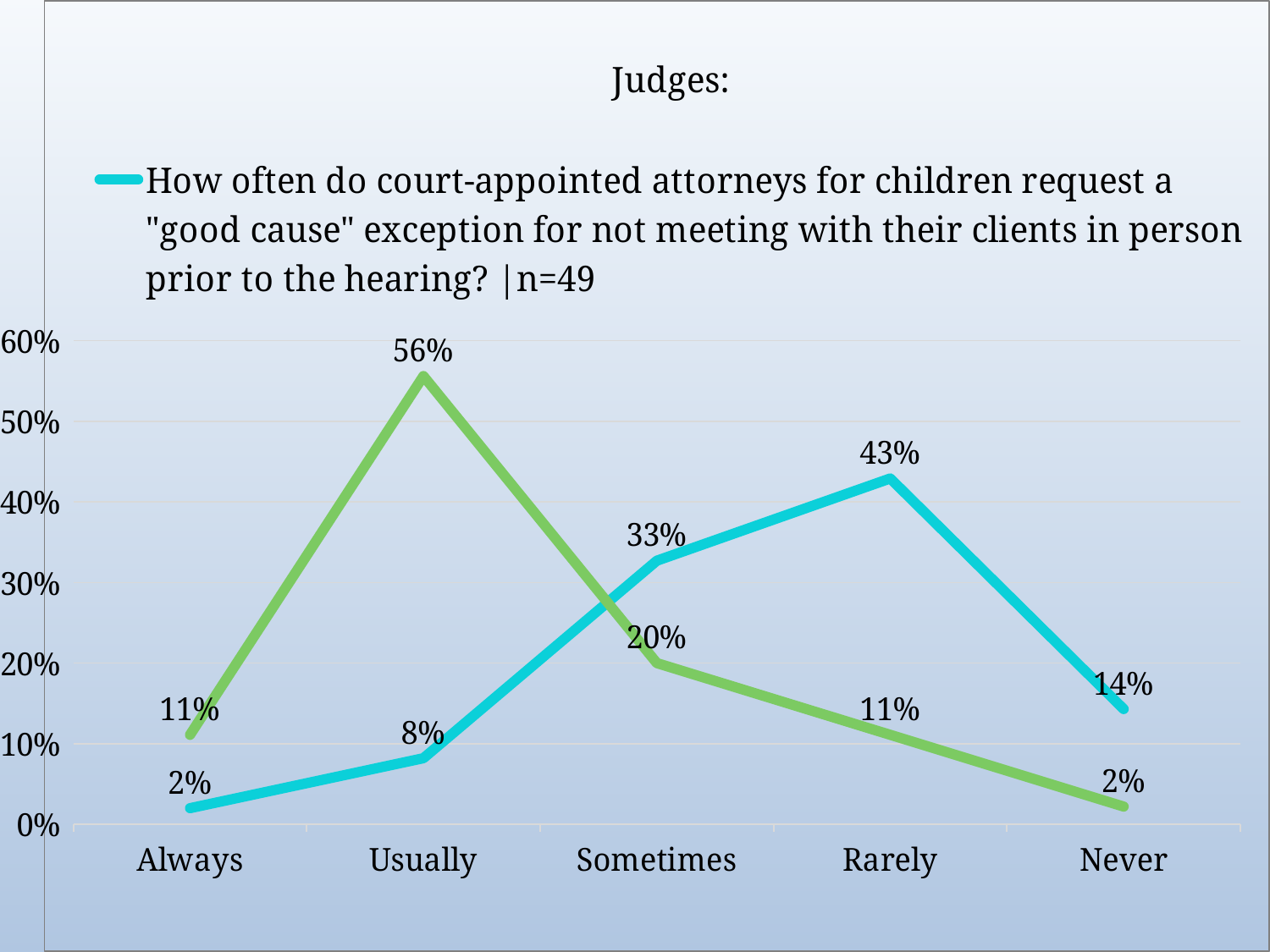
How many series does the legend list? 1 For Sometimes, which line has the larger value, the cyan line or the green line? The cyan line Does the green line rise or fall from Usually to Never? Fall What is the difference between the cyan line's value for Rarely and its value for Never? 29% What is the value of the cyan line for Always? 2% How many categories are shown on the x axis? 5 What is the value of the cyan line for Rarely? 43% What is the title of the chart? Judges: Which category has the lowest value on the green line? Never What is the value of the green line for Usually? 56% What type of chart is shown on the slide? Line chart Which category has the highest value on the cyan line? Rarely